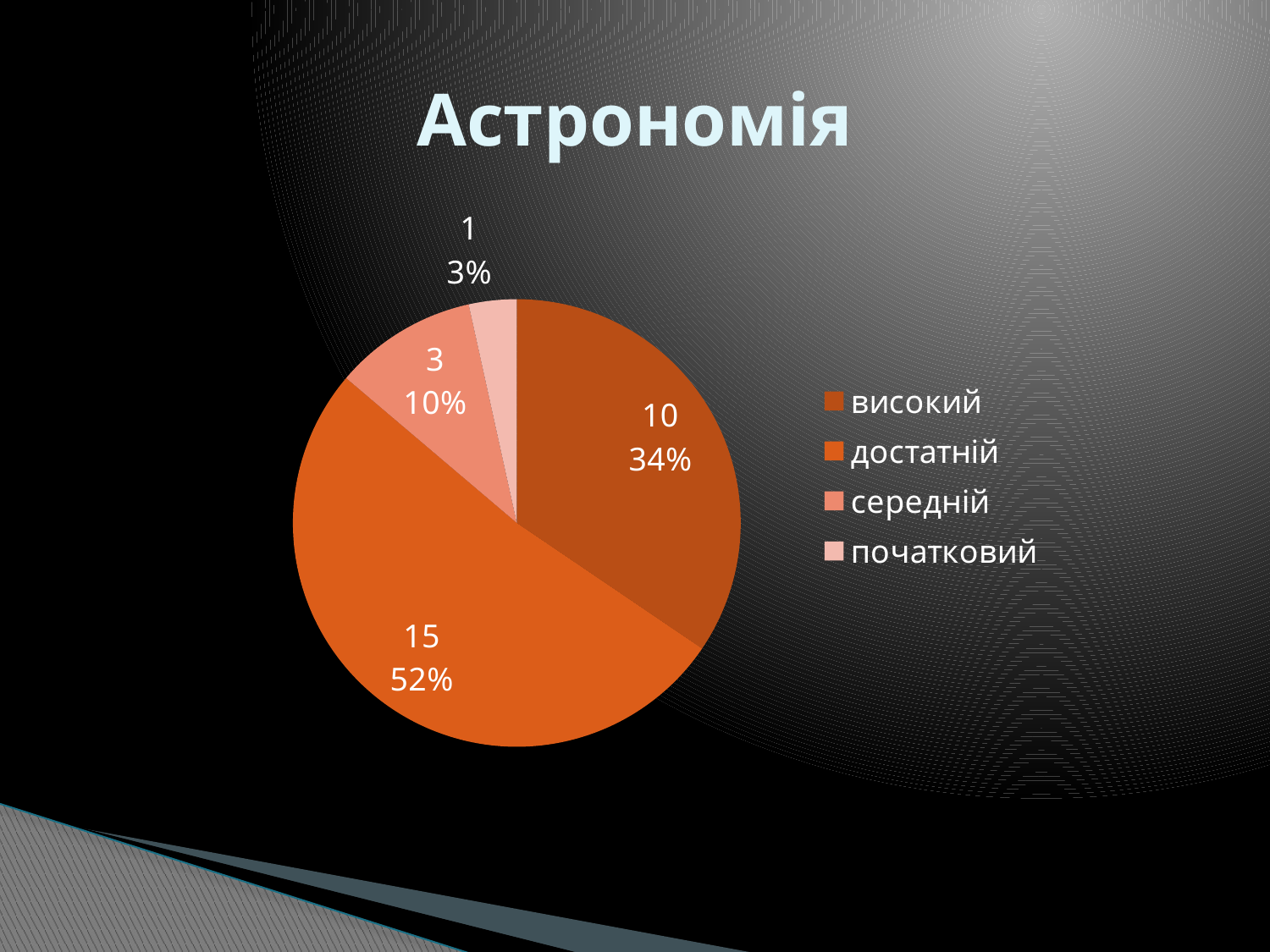
What is the value for високий? 10 What is the difference between the values for достатній and високий? 5 What share of the pie does високий take? 34% Which category has the smallest slice? початковий What is the title of the chart? Астрономія What is the value for достатній? 15 What share of the pie does достатній take? 52% What is the value for початковий? 1 How many slices does the pie chart have? 4 What is the value for середній? 3 Which category has the largest slice? достатній What kind of chart is shown on the slide? pie chart